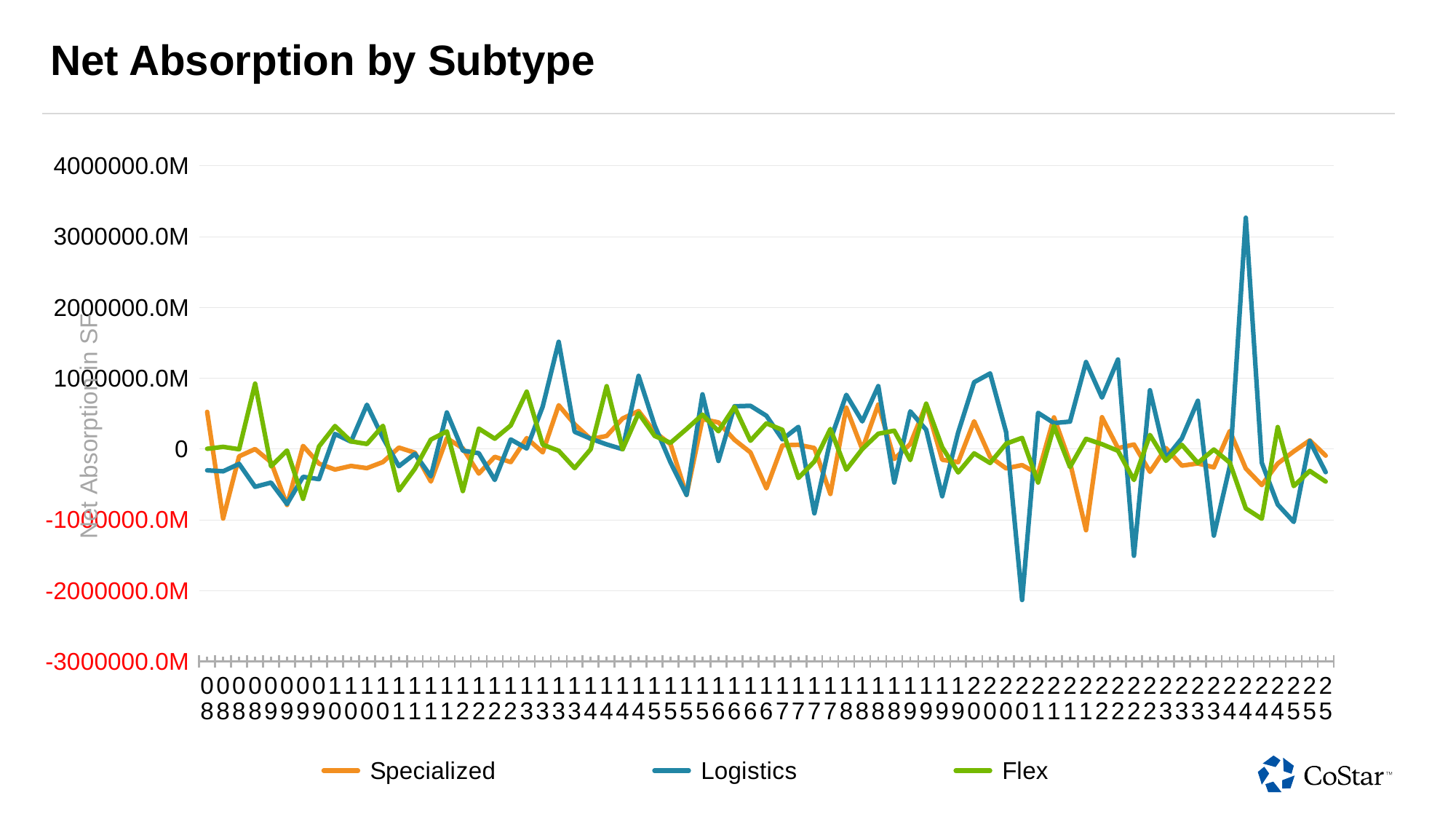
Which series reaches the lowest point on the chart? Logistics Which series has the higher peak, Logistics or Flex? Logistics What kind of chart is shown on the slide? Line chart Which series is drawn in orange? Specialized Is the lowest value of the Logistics series greater or less than -2000000.0M? less Is the highest value of the Logistics series greater or less than 3000000.0M? greater How many series does the legend list? 3 Is the highest value of the Specialized series greater or less than 1000000.0M? less What is the title of the chart? Net Absorption by Subtype Which series reaches the highest peak on the chart? Logistics